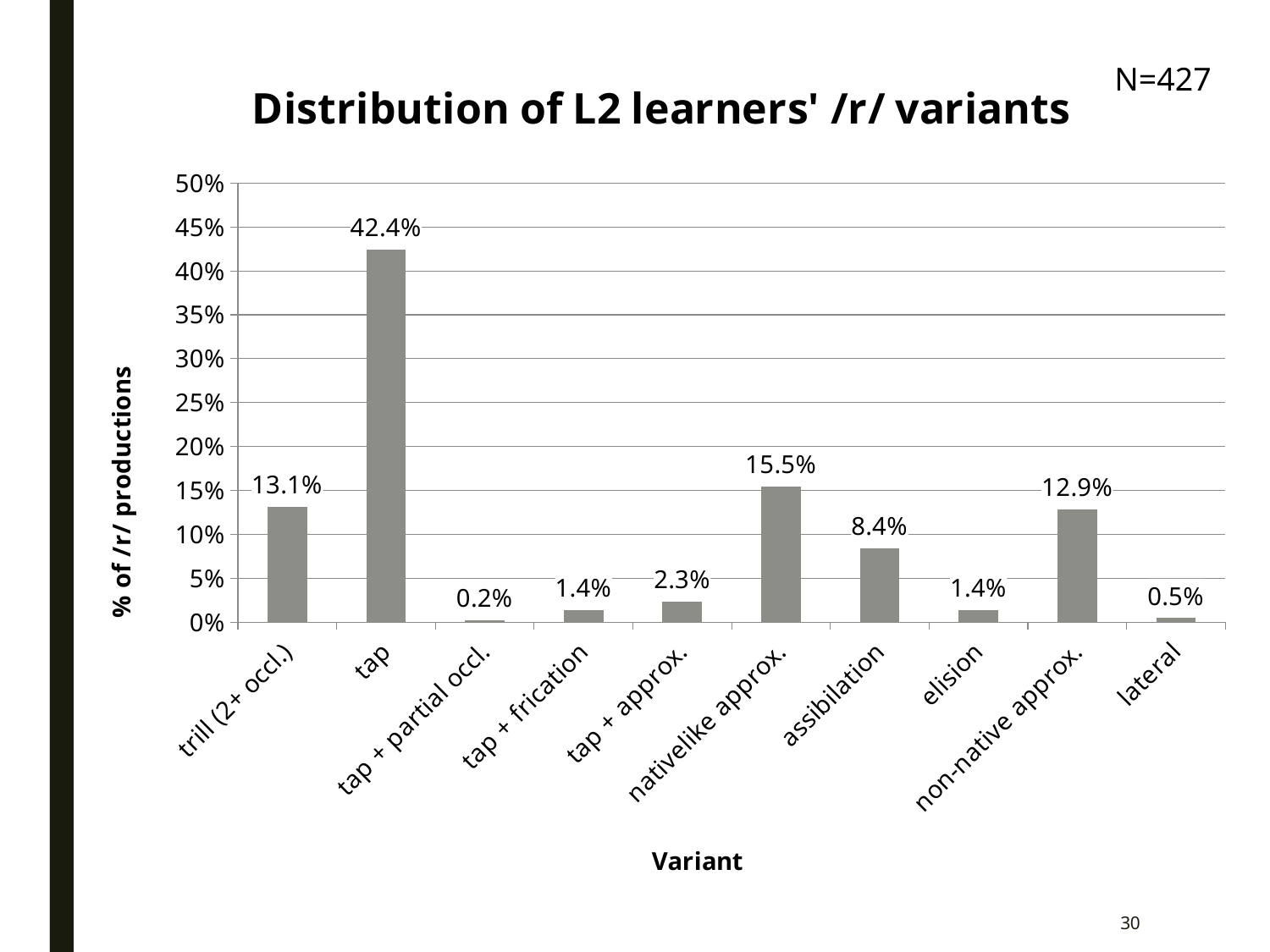
Which variant has the lowest percentage of /r/ productions? tap + partial occl. How many variant categories are shown on the x axis? 10 Is the value for tap greater or less than 40%? greater What is the difference between the values for trill (2+ occl.) and non-native approx.? 0.2% Which is larger, the value for nativelike approx. or the value for non-native approx.? nativelike approx. What is the difference between the values for tap and nativelike approx.? 26.9% What is the title of the chart? Distribution of L2 learners' /r/ variants What is the value for assibilation? 8.4% What percentage of /r/ productions is the tap variant? 42.4% What is the value for nativelike approx.? 15.5% What kind of chart is shown on the slide? bar chart Which variant has the highest percentage of /r/ productions? tap